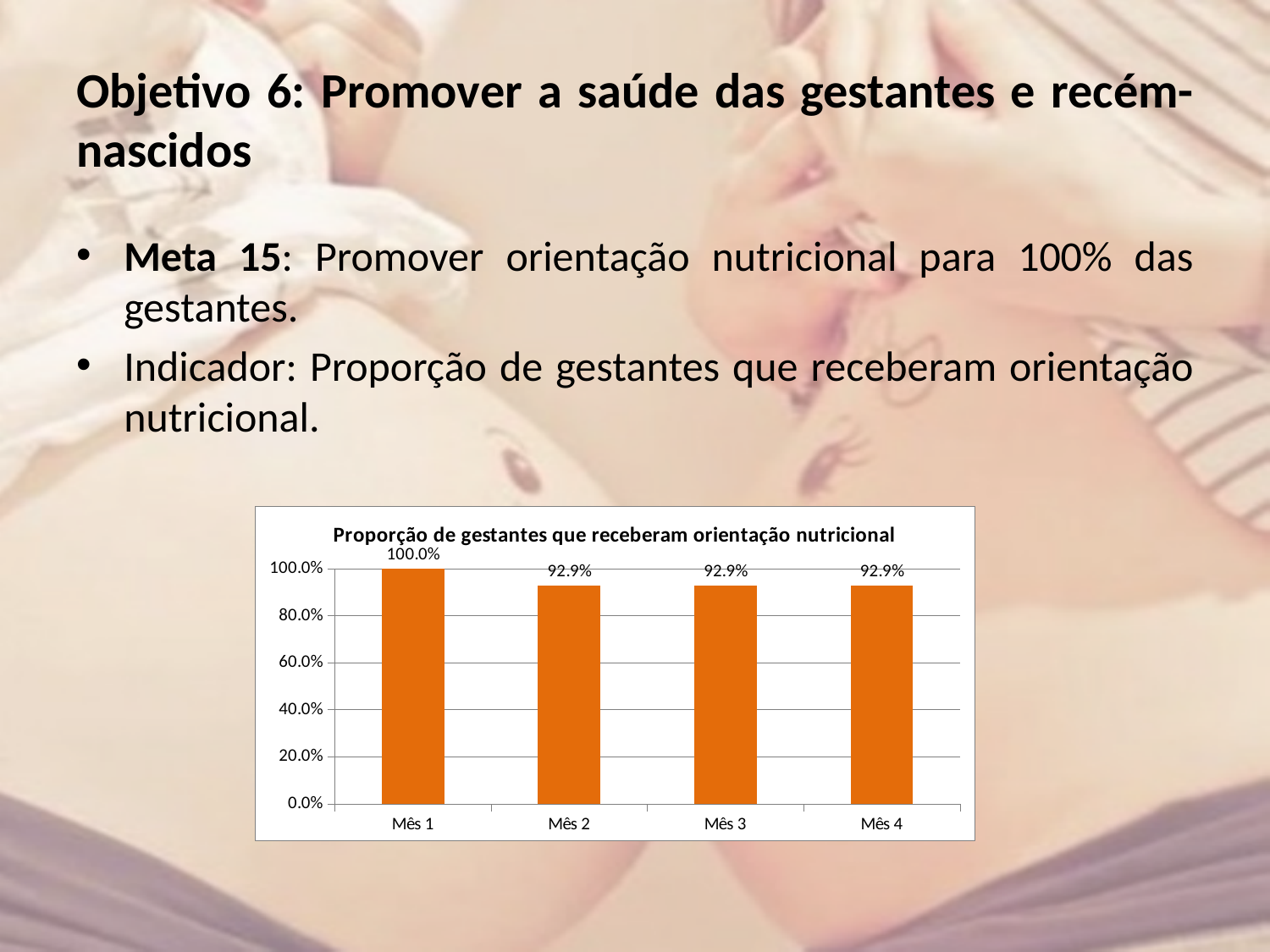
What colour are the bars in the chart? orange Is the value for Mês 2 greater or less than 80.0%? greater Do the values rise or fall from Mês 1 to Mês 2? fall How many months have a value of 92.9%? 3 Which is larger, the value for Mês 1 or the value for Mês 4? Mês 1 What kind of chart is shown on the slide? bar chart What is the title of the chart? Proporção de gestantes que receberam orientação nutricional Which month has the highest value? Mês 1 What is the value for Mês 3? 92.9% How many months are shown on the x axis? 4 What is the difference between the values for Mês 1 and Mês 2? 7.1% What is the value for Mês 1? 100.0%